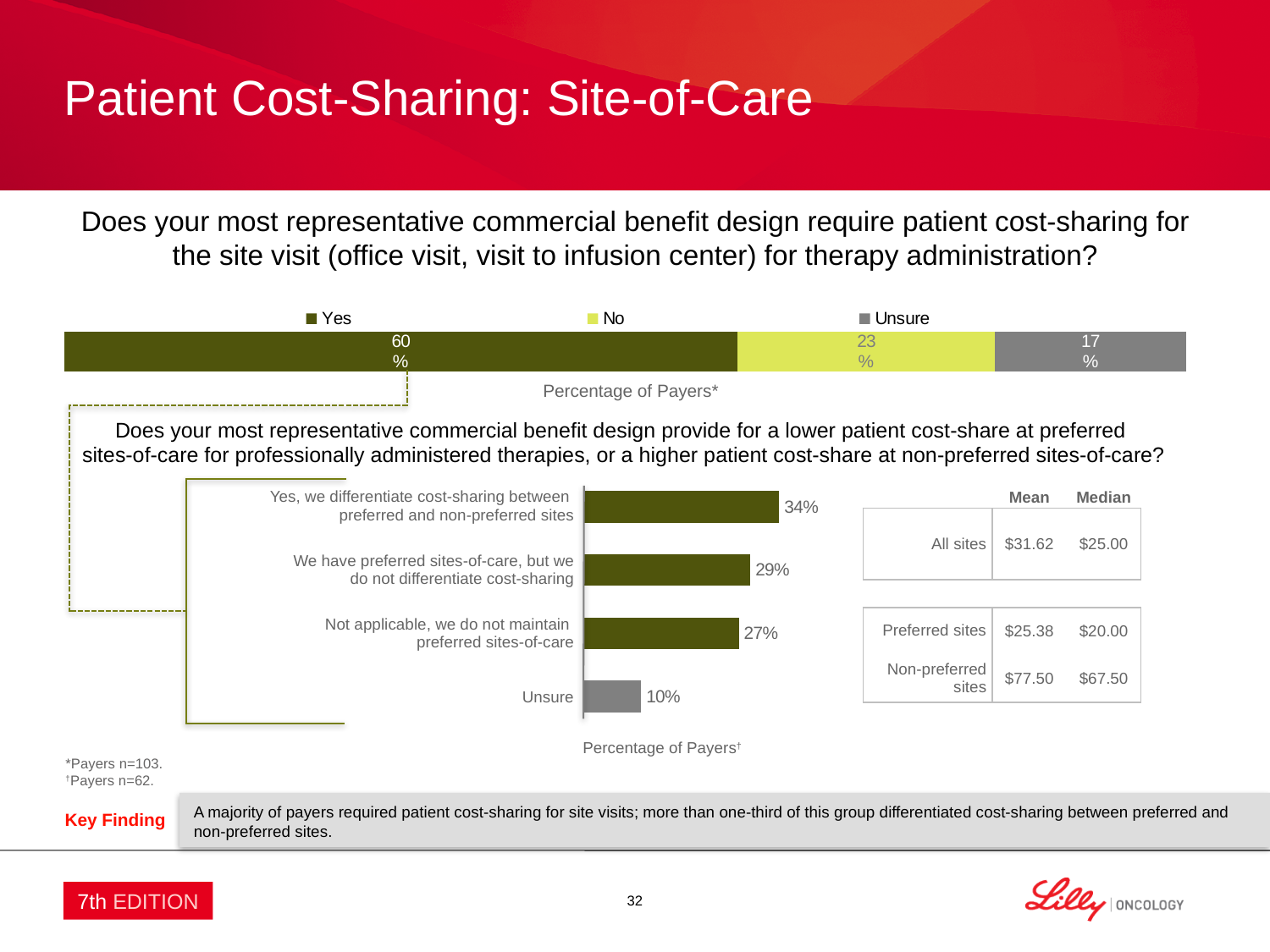
In the lower bar chart, what percentage of payers answered Unsure? 10% How many series does the legend of the top stacked bar chart list? 3 In the top stacked bar chart, what is the difference between the Yes and No percentages? 37% In the lower bar chart, which category has the lowest value? Unsure In the lower bar chart, what is the difference between 'We have preferred sites-of-care, but we do not differentiate cost-sharing' and 'Not applicable, we do not maintain preferred sites-of-care'? 2% In the top stacked bar chart, what percentage of payers answered Yes? 60% In the top stacked bar chart, what percentage of payers answered Unsure? 17% In the lower bar chart, which category has the highest value? Yes, we differentiate cost-sharing between preferred and non-preferred sites In the top stacked bar chart, what percentage of payers answered No? 23% In the top stacked bar chart, what is the total of the three segments? 100% In the lower bar chart, what percentage of payers said they differentiate cost-sharing between preferred and non-preferred sites? 34% How many categories are shown in the lower bar chart? 4